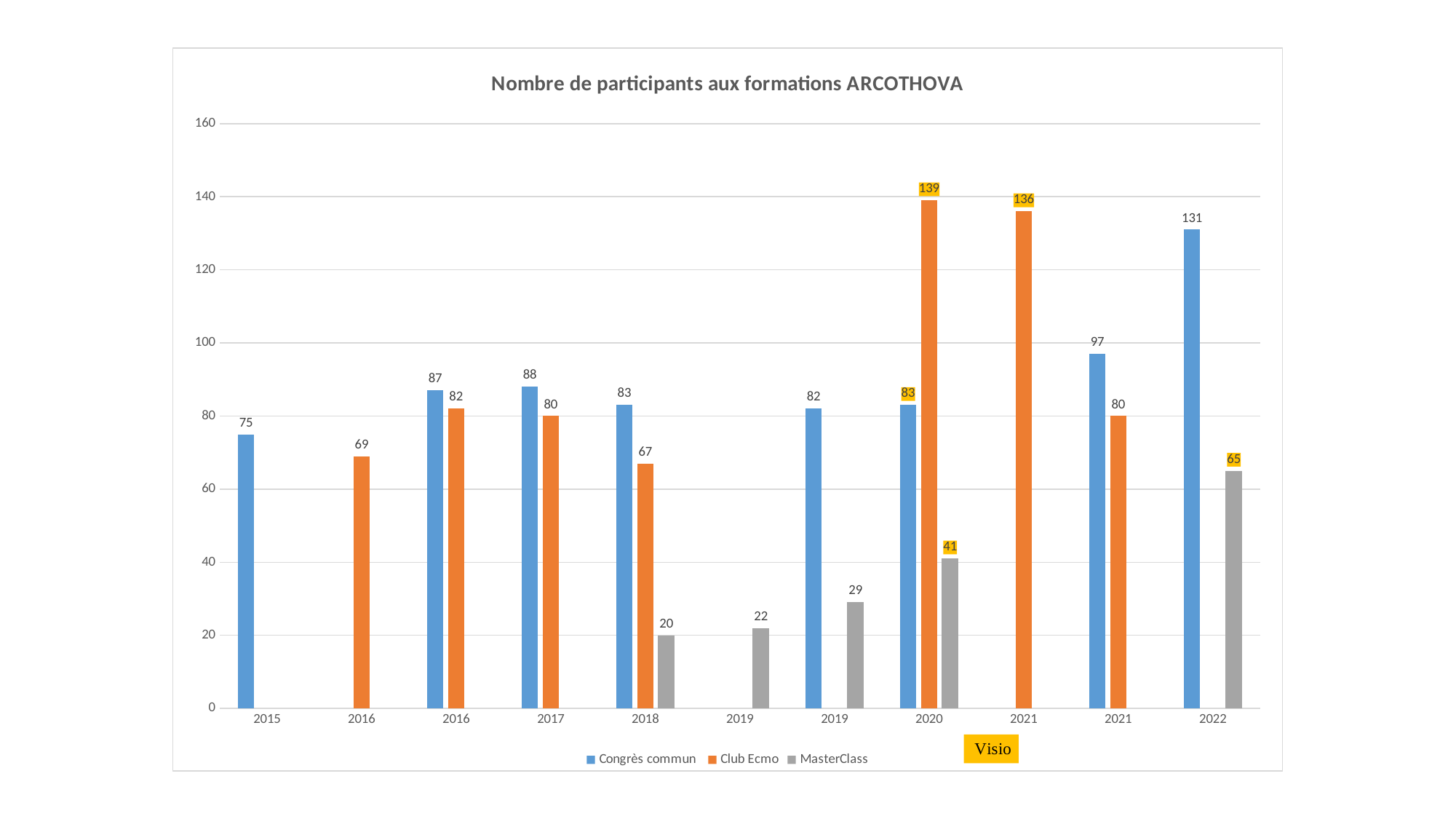
In which year does Club Ecmo reach its highest value? 2020 What type of chart is shown on the slide? bar chart How many series does the legend list? 3 What is the value for Club Ecmo in 2020? 139 What is the lowest value shown for MasterClass? 20 What is the value for Congrès commun in 2015? 75 What is the value for Congrès commun in 2017? 88 In 2020, what is the difference between the Club Ecmo value and the Congrès commun value? 56 What is the value for MasterClass in 2022? 65 What is the title of the chart? Nombre de participants aux formations ARCOTHOVA Which is larger: Congrès commun in 2022 or Club Ecmo in 2020? Club Ecmo in 2020 In which year does Congrès commun reach its highest value? 2022